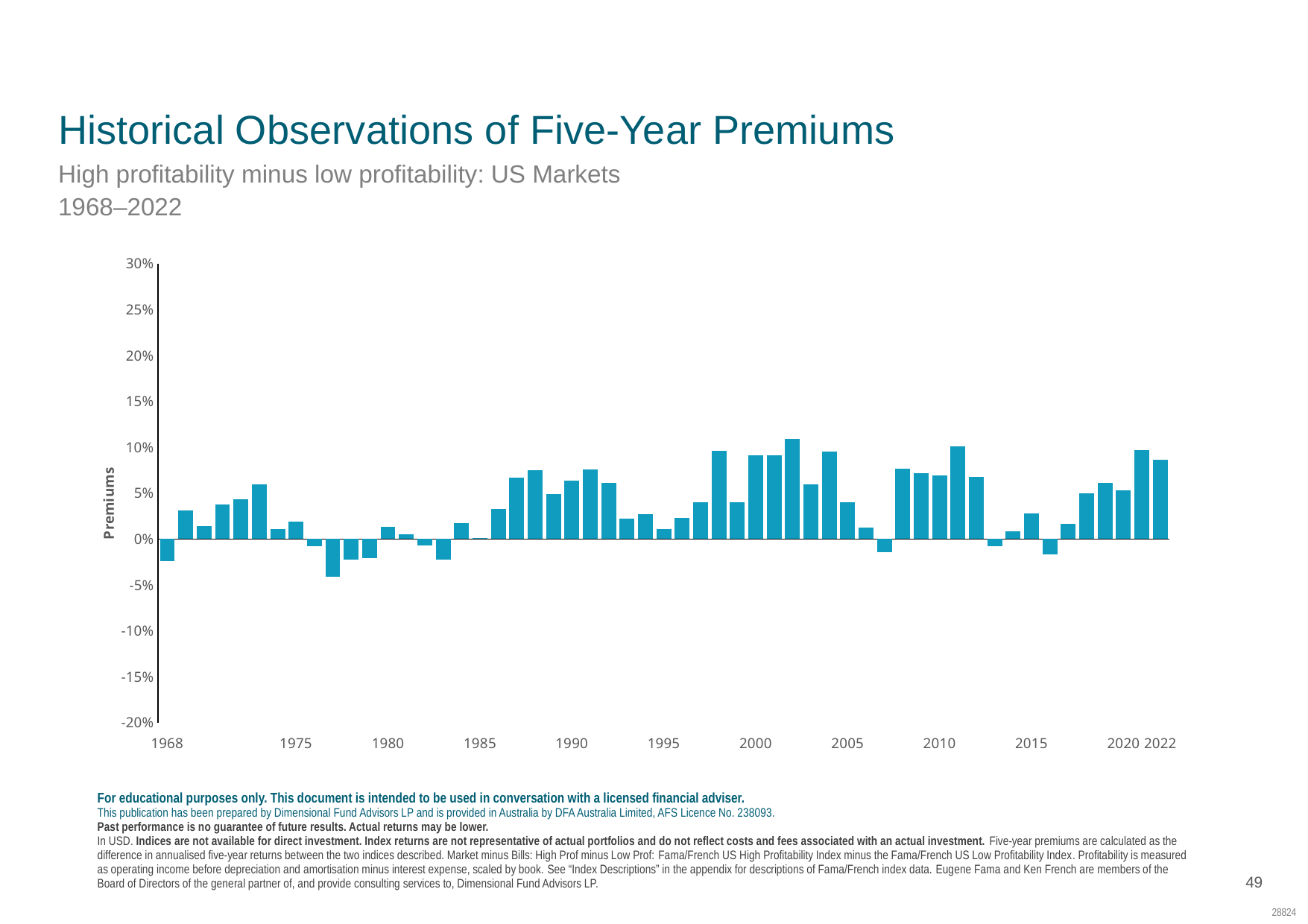
Is the value for 2021 greater or less than 5%? greater Is the value for 1977 greater or less than 0%? less What is the label on the vertical axis of the chart? Premiums Is the value for 2000 greater or less than 5%? greater What is the title of the chart on the slide? Historical Observations of Five-Year Premiums Which is larger, the value for 1968 or the value for 1969? 1969 What kind of chart is shown on the slide? bar chart Which is larger, the value for 2002 or the value for 2005? 2002 Which year has the lowest five-year premium in the chart? 1977